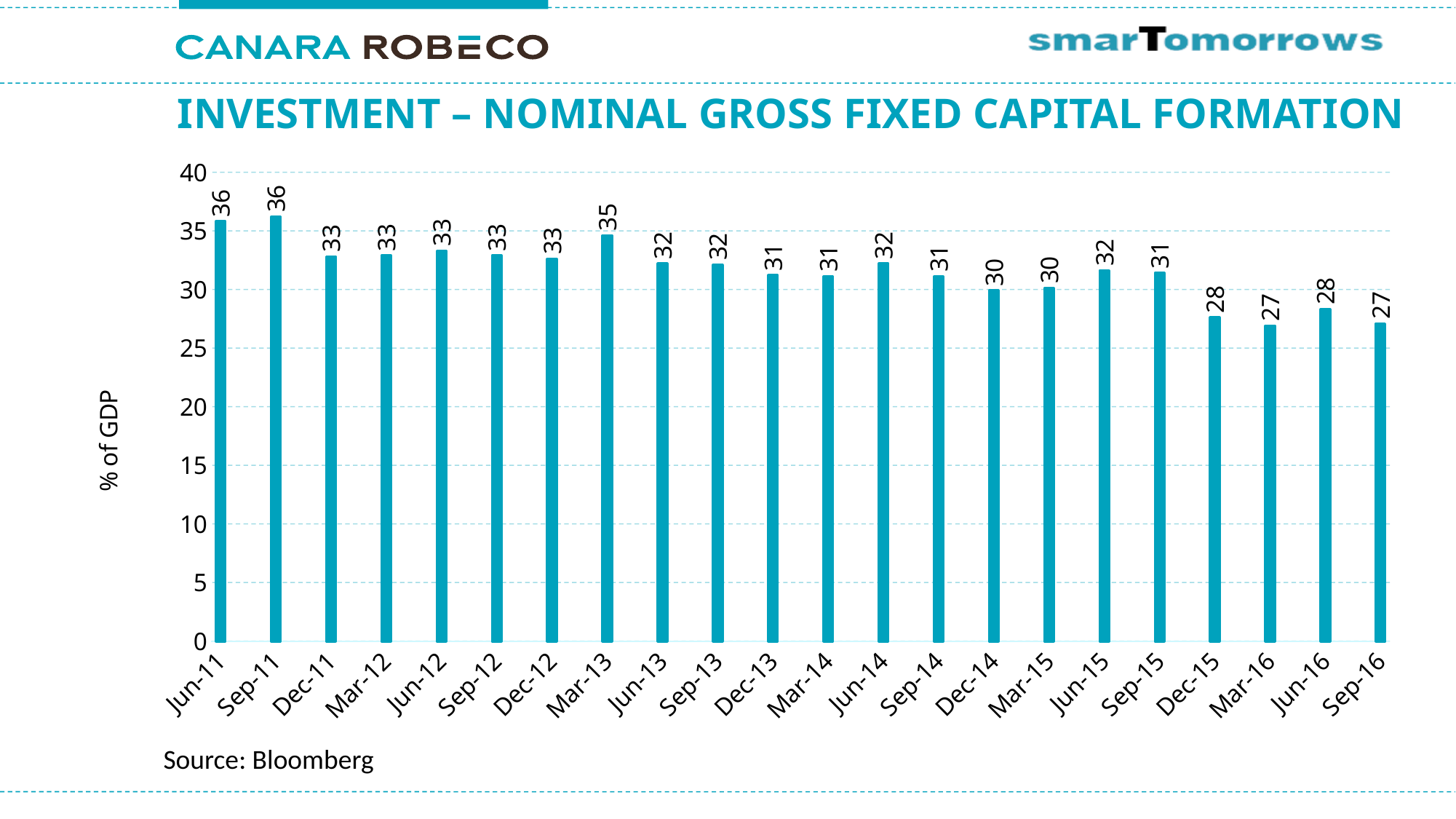
What is the value for Mar-13? 35 What is the difference between the values for Mar-13 and Dec-15? 7 What is the value for Jun-11? 36 Do the values generally rise or fall from Jun-11 to Sep-16? fall What is the difference between the values for Jun-11 and Sep-16? 9 How many bars (quarters) are plotted in the chart? 22 What is the value for Dec-14? 30 What kind of chart is shown on the slide? bar chart Which is larger, the value for Mar-13 or the value for Jun-13? Mar-13 What is the label on the vertical axis of the chart? % of GDP What is the value for Sep-16? 27 Is the value for Dec-15 greater or less than 30? less